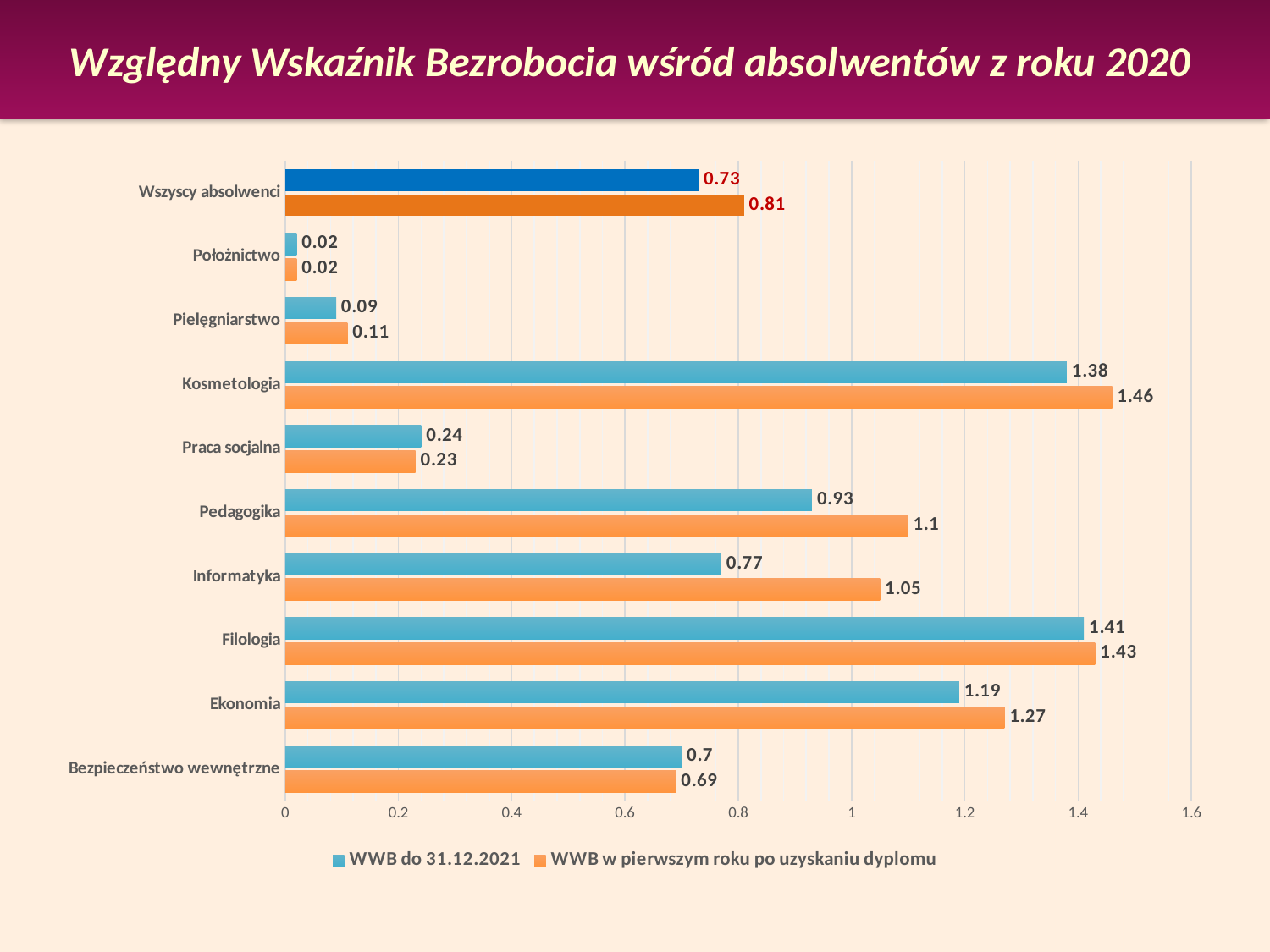
How many series does the legend list? 2 What kind of chart is shown on the slide? Bar chart What is the value of 'WWB w pierwszym roku po uzyskaniu dyplomu' for Informatyka? 1.05 Which category has the highest value for 'WWB w pierwszym roku po uzyskaniu dyplomu'? Kosmetologia What is the difference between the 'WWB w pierwszym roku po uzyskaniu dyplomu' and 'WWB do 31.12.2021' values for Informatyka? 0.28 Which is larger for Pedagogika: 'WWB do 31.12.2021' or 'WWB w pierwszym roku po uzyskaniu dyplomu'? WWB w pierwszym roku po uzyskaniu dyplomu How many categories are shown on the y axis of the chart? 10 What is the value of 'WWB do 31.12.2021' for Kosmetologia? 1.38 What is the value of 'WWB do 31.12.2021' for Wszyscy absolwenci? 0.73 What is the difference between the 'WWB do 31.12.2021' values for Filologia and Ekonomia? 0.22 Which category has the lowest value for 'WWB do 31.12.2021'? Położnictwo Is the 'WWB w pierwszym roku po uzyskaniu dyplomu' value for Ekonomia greater or less than 1.2? greater